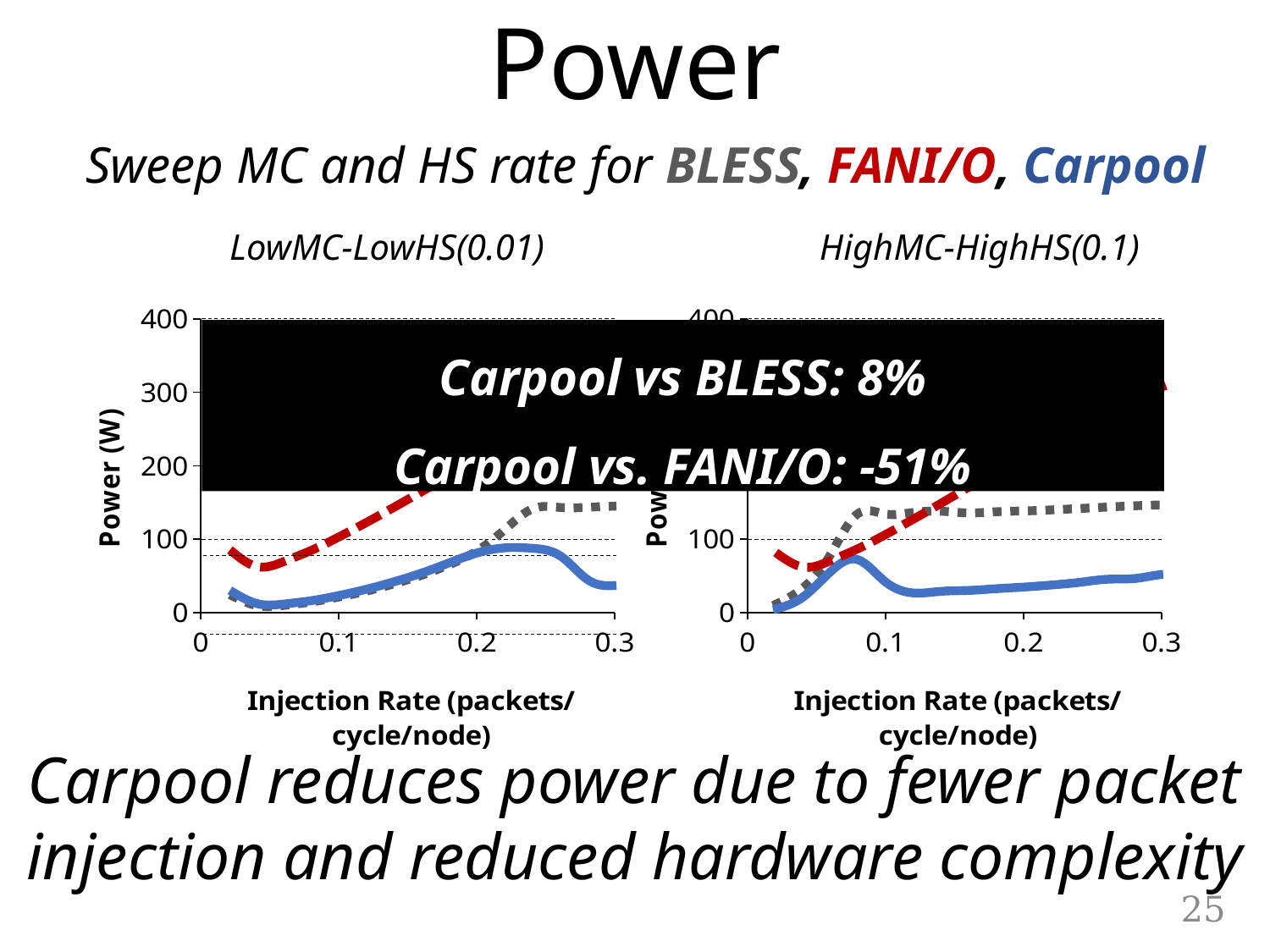
According to the overlay text on the charts, what is the Carpool vs. FANI/O power difference? -51% In the LowMC-LowHS(0.01) chart, is the BLESS value at injection rate 0.3 greater or less than 100? greater In the LowMC-LowHS(0.01) chart, is the Carpool value at injection rate 0.3 greater or less than 100? less What kind of chart is the LowMC-LowHS(0.01) chart on the left? line chart In the HighMC-HighHS(0.1) chart, which series has the higher power at injection rate 0.3, BLESS or Carpool? BLESS In the LowMC-LowHS(0.01) chart, which series has the higher power at injection rate 0.3, BLESS or Carpool? BLESS How many series (BLESS, FANI/O, Carpool) are plotted in each chart? 3 In the HighMC-HighHS(0.1) chart, is the Carpool value at injection rate 0.3 greater or less than 100? less How many charts are shown on the slide? 2 In the HighMC-HighHS(0.1) chart, does the BLESS line generally rise or fall as injection rate increases from 0 to 0.3? rise What is the y-axis label of the left chart? Power (W)